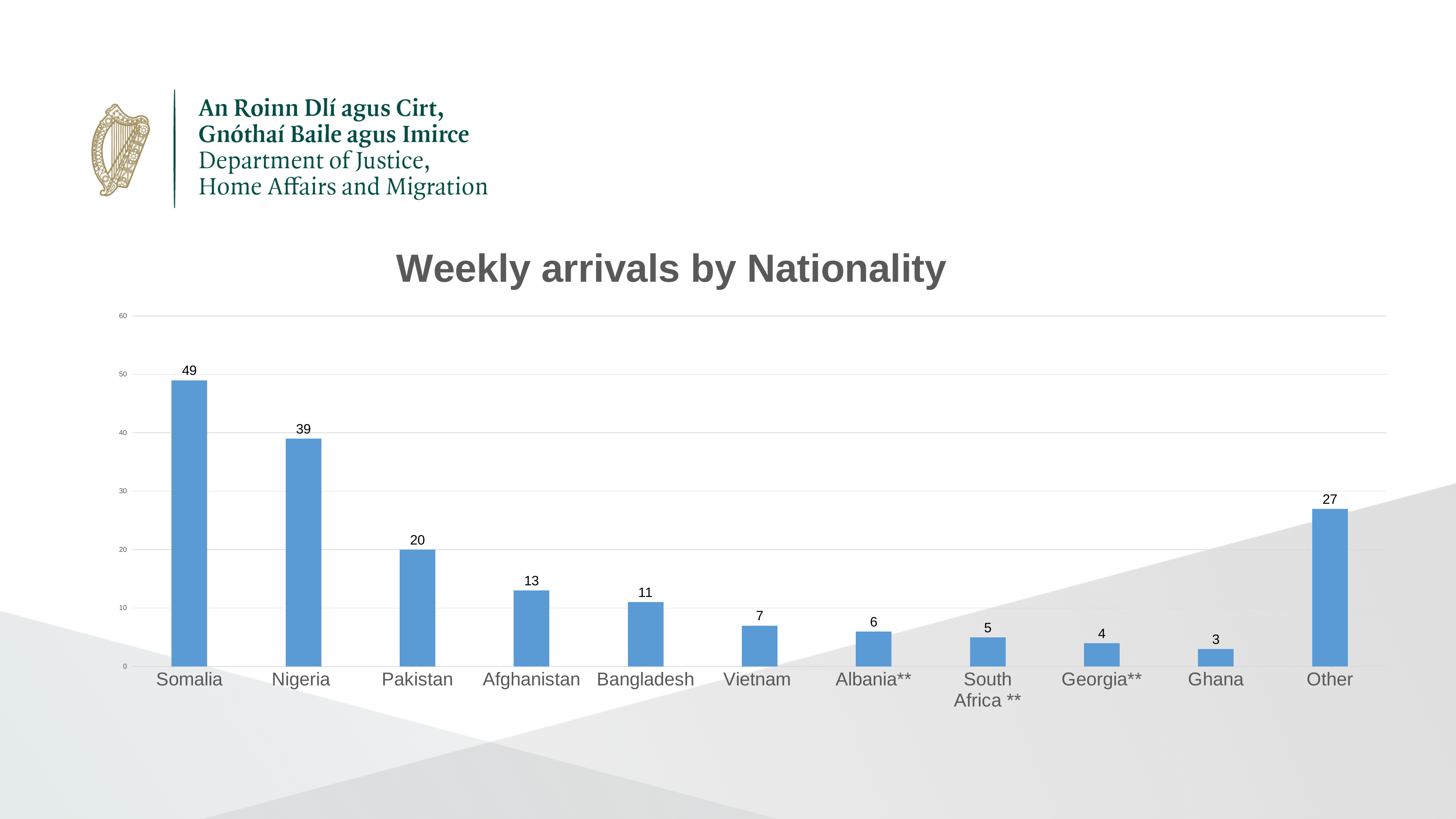
Which category has the lowest value? Ghana What is the value for Somalia? 49 What is the value for Other? 27 How many categories are shown on the x axis? 11 Is the value for Nigeria greater or less than 30? greater What is the value for Pakistan? 20 Which nationality has the highest number of weekly arrivals? Somalia Which is larger, the value for Afghanistan or the value for Bangladesh? Afghanistan What is the title of the chart? Weekly arrivals by Nationality What kind of chart is shown on the slide? Bar chart What is the difference between the values for Somalia and Nigeria? 10 What is the value for Vietnam? 7